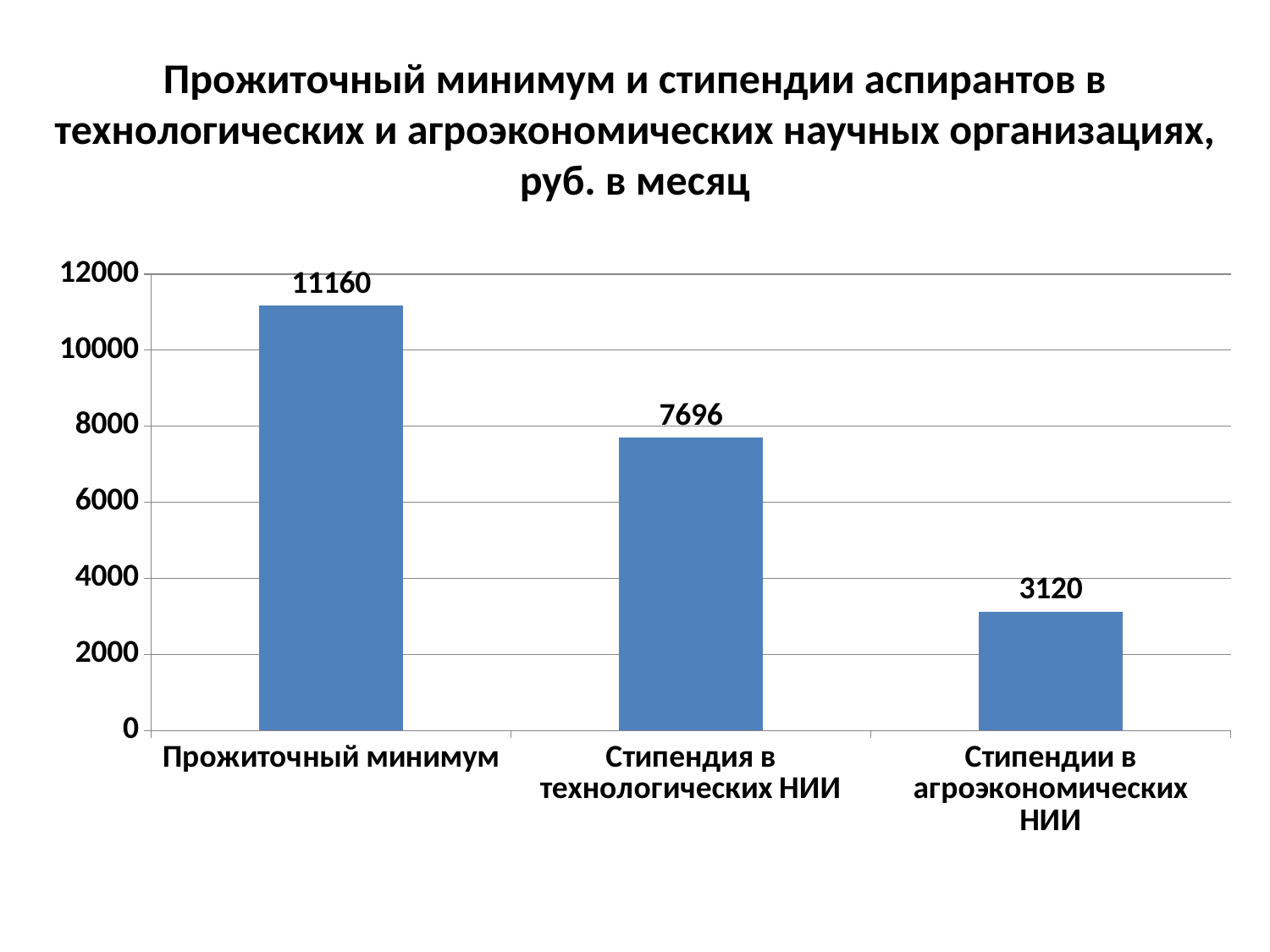
How many categories are shown in the chart? 3 What kind of chart is shown on the slide? bar chart Which category has the lowest value? Стипендии в агроэкономических НИИ Do the values rise or fall from left to right across the categories? fall What is the difference between Стипендия в технологических НИИ and Стипендии в агроэкономических НИИ? 4576 What is the value for Стипендии в агроэкономических НИИ? 3120 Is the value for Стипендия в технологических НИИ greater or less than 8000? less Which is larger: Стипендия в технологических НИИ or Стипендии в агроэкономических НИИ? Стипендия в технологических НИИ What is the value for Стипендия в технологических НИИ? 7696 Which category has the highest value? Прожиточный минимум What is the difference between Прожиточный минимум and Стипендия в технологических НИИ? 3464 What is the value for Прожиточный минимум? 11160